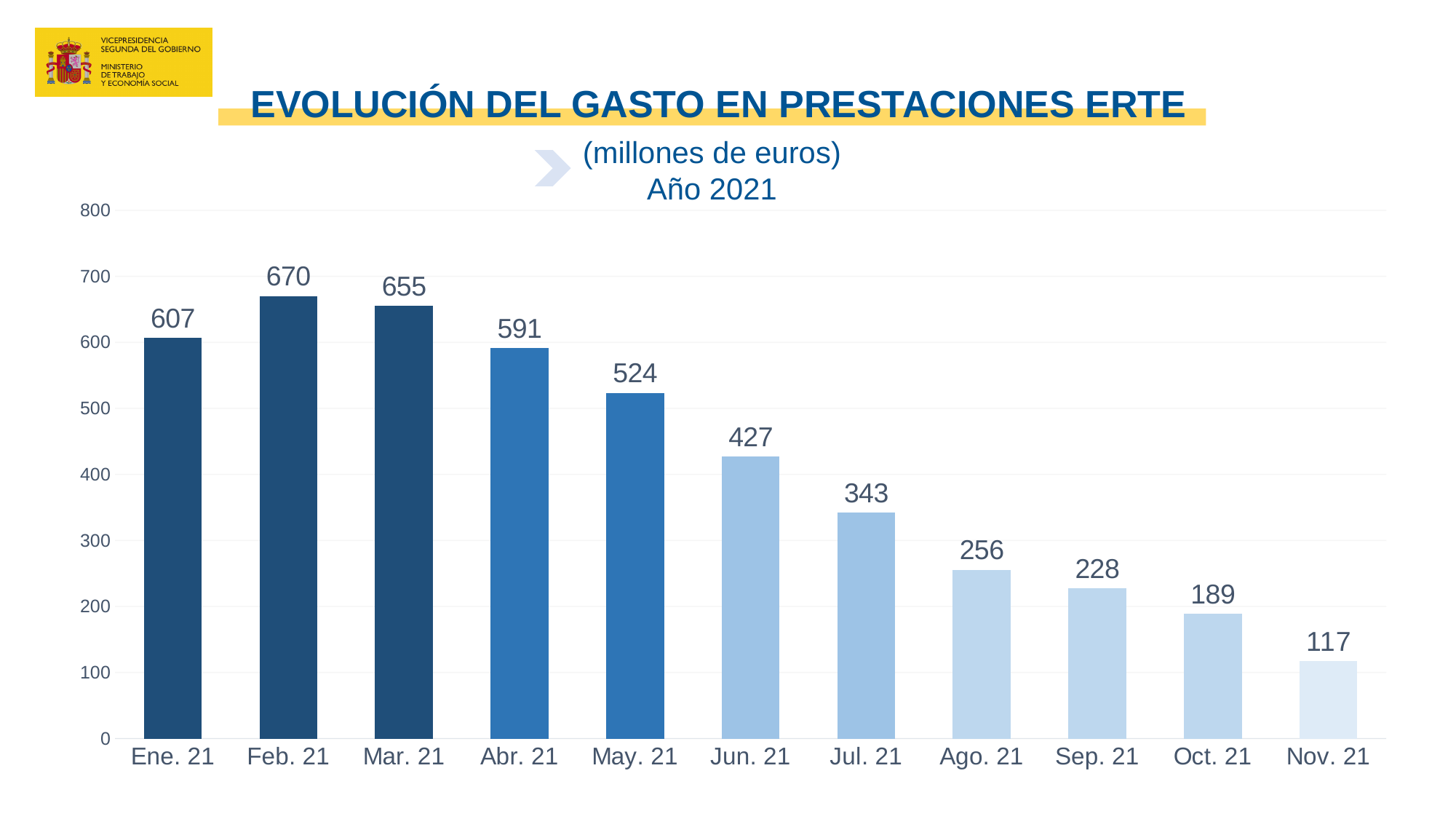
What is the difference between the values for Jun. 21 and Jul. 21? 84 What kind of chart is shown on the slide? bar chart Which month has the highest value? Feb. 21 What is the difference between the values for Ene. 21 and Feb. 21? 63 What is the value for Feb. 21? 670 Which month has the lowest value? Nov. 21 How many months are shown on the x axis? 11 What is the value for Nov. 21? 117 Which is larger, the value for Mar. 21 or the value for Abr. 21? Mar. 21 What is the value for Jun. 21? 427 Do the values rise or fall from Feb. 21 to Nov. 21? fall Is the value for May. 21 greater or less than 500? greater